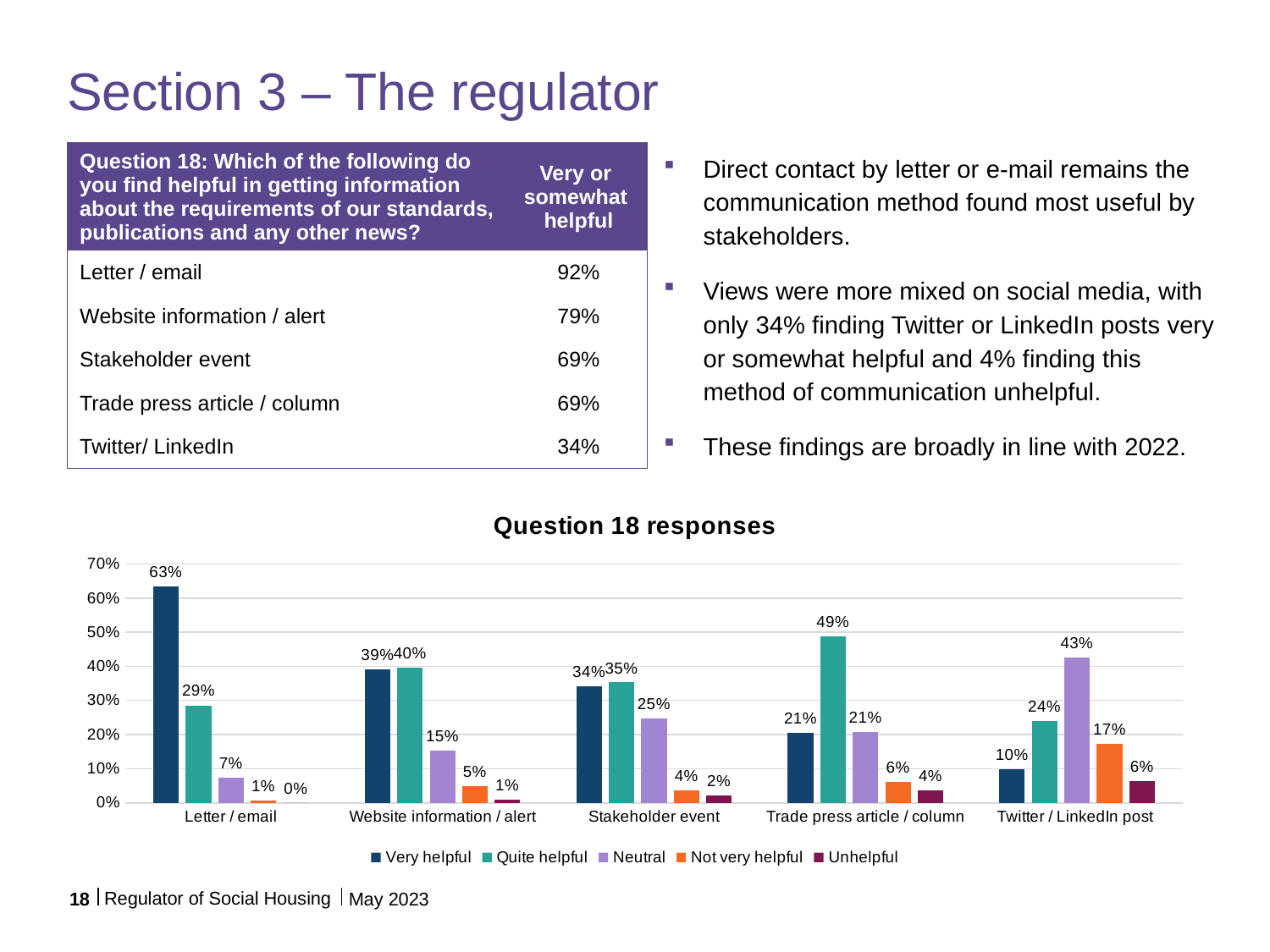
How many series does the chart legend list? 5 How many categories are shown on the x axis of the chart? 5 Which category has the highest Very helpful value? Letter / email What is the Quite helpful value for Trade press article / column? 49% Does the Very helpful value fall or rise from Letter / email to Twitter / LinkedIn post along the x axis? fall Which is larger for Stakeholder event: the Neutral value or the Not very helpful value? Neutral What is the title of the chart? Question 18 responses Which category has the lowest Very helpful value? Twitter / LinkedIn post What is the difference between the Very helpful and Quite helpful values for Letter / email? 34% What kind of chart is shown on the slide? bar chart What is the Neutral value for Twitter / LinkedIn post? 43% What is the Very helpful value for Letter / email? 63%